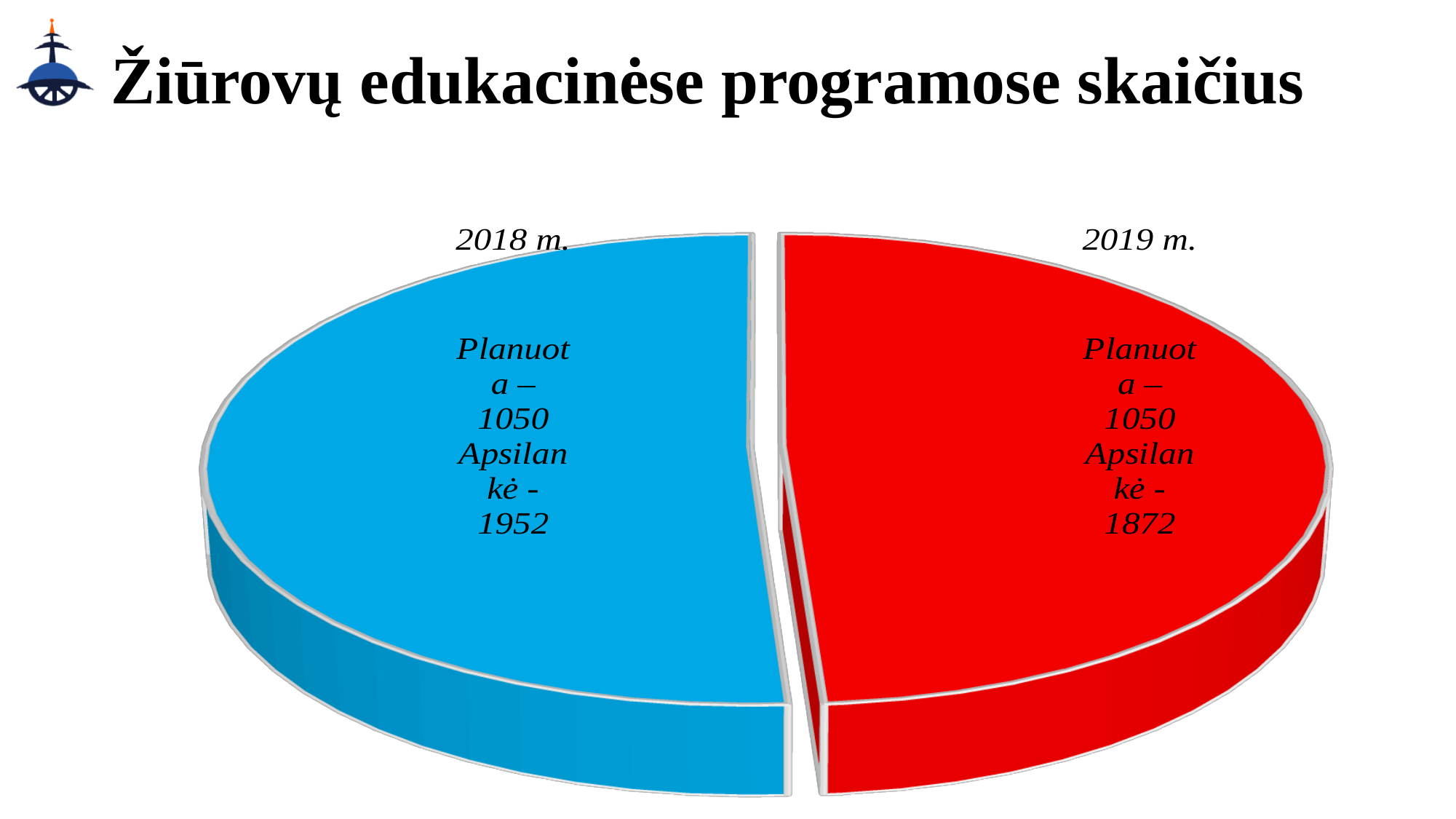
How many slices does the pie chart have? 2 By how much did the 2018 m. visitor number (Apsilankė) exceed the planned number (Planuota)? 902 What is the title of the chart on the slide? Žiūrovų edukacinėse programose skaičius What was the planned number (Planuota) for 2018 m.? 1050 Which colour is the slice for 2019 m.? red How many visitors (Apsilankė) are shown for 2019 m.? 1872 Which year has the lowest number of visitors (Apsilankė)? 2019 m. How many visitors (Apsilankė) are shown for 2018 m.? 1952 What type of chart is shown on the slide? pie chart What is the difference between the visitor numbers (Apsilankė) for 2018 m. and 2019 m.? 80 What was the planned number (Planuota) for 2019 m.? 1050 Which year has the higher number of visitors (Apsilankė), 2018 m. or 2019 m.? 2018 m.